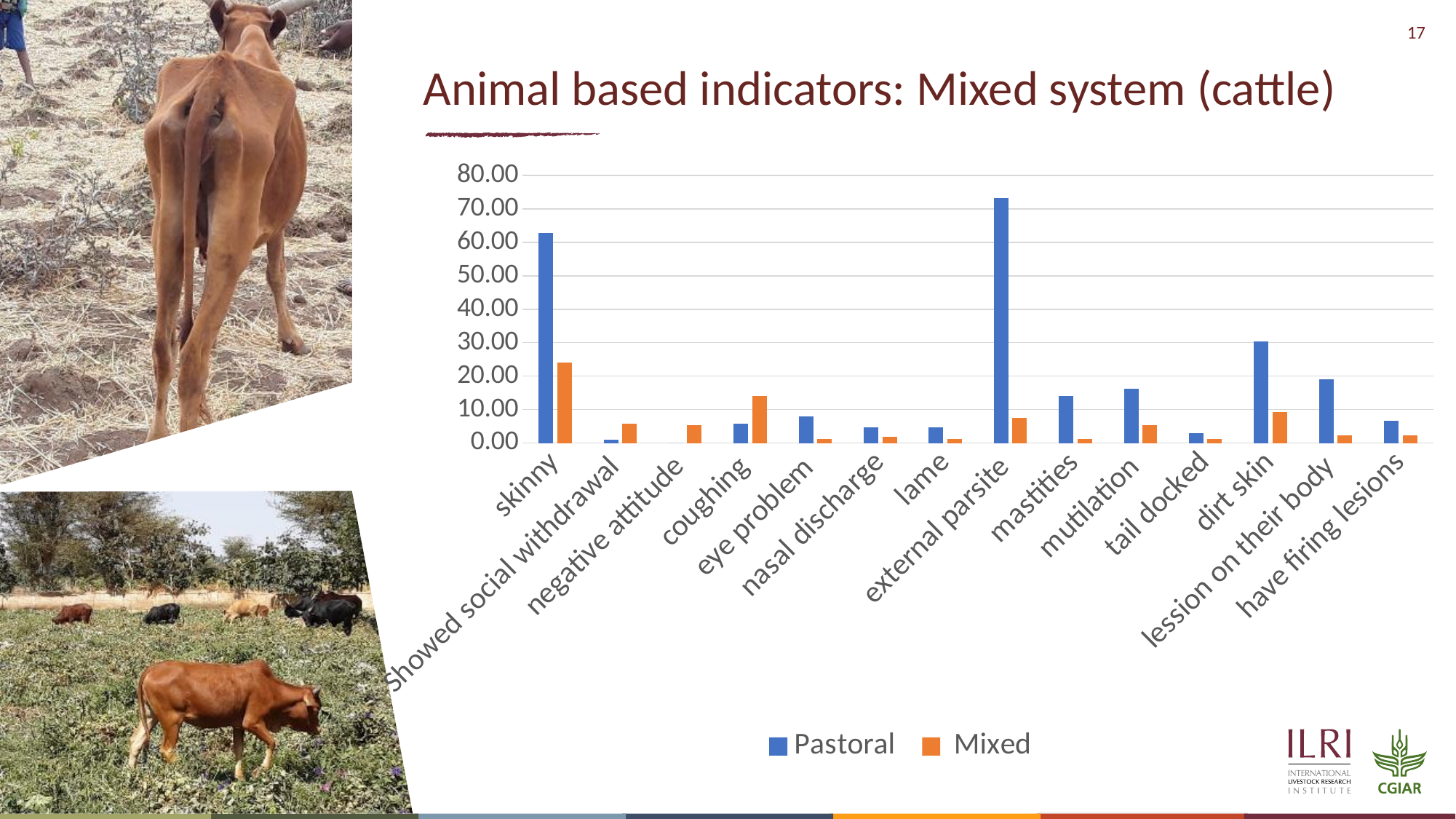
Is the Pastoral value for skinny greater or less than 60.00? greater How many categories are shown on the x axis? 14 Is the Mixed value for skinny greater or less than 20.00? greater Which colour represents the Mixed series in the legend? orange Which category has the highest Mixed value? skinny Is the Pastoral value for dirt skin greater or less than 20.00? greater Which category has the highest Pastoral value? external parsite For coughing, which series has the larger value, Pastoral or Mixed? Mixed What kind of chart is shown on the slide? bar chart How many series does the legend list? 2